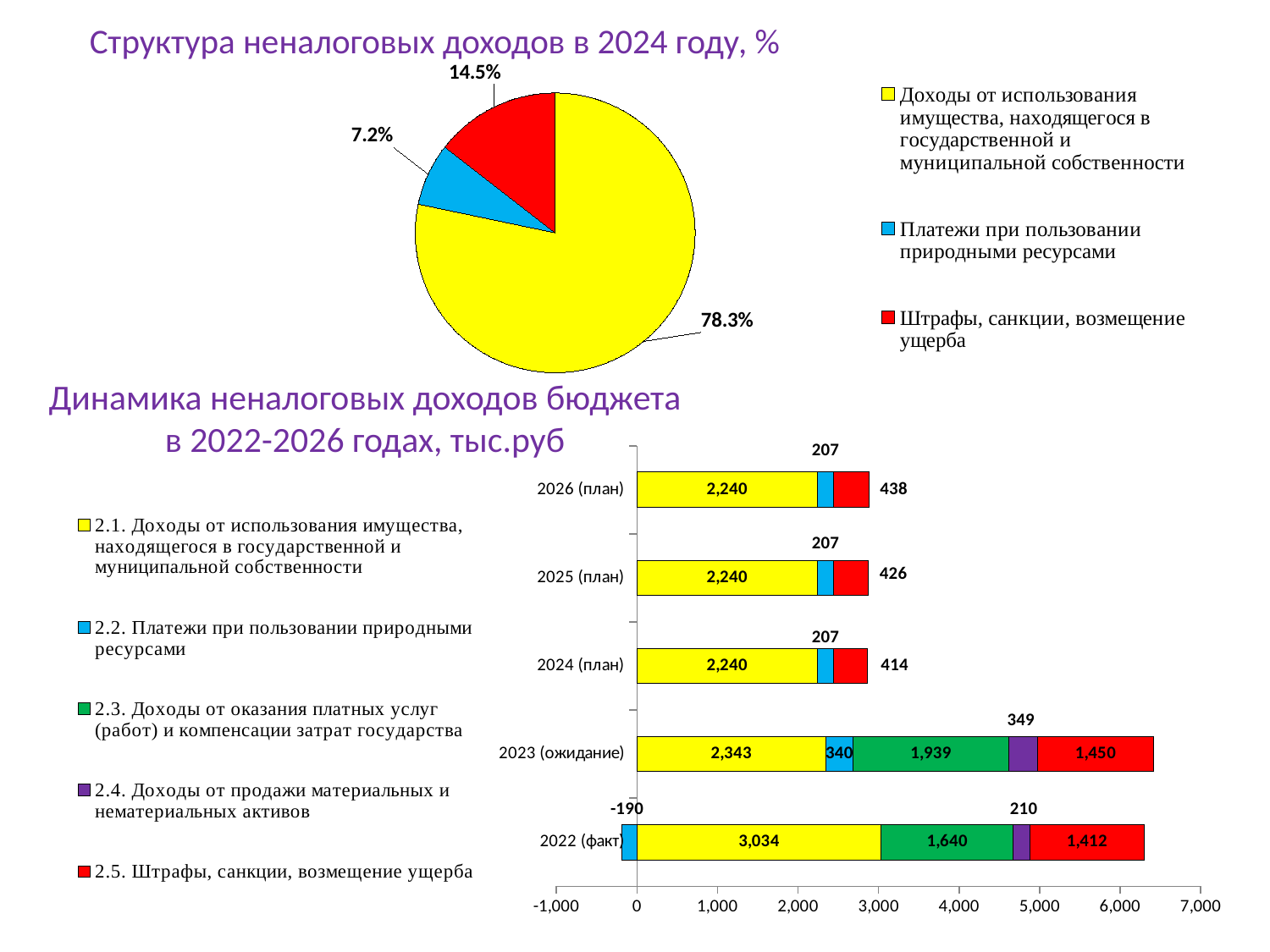
In the chart "Динамика неналоговых доходов бюджета в 2022-2026 годах, тыс.руб", what is the difference between the "2.1. Доходы от использования имущества" values for 2022 (факт) and 2023 (ожидание)? 691 What kind of chart is the chart titled "Структура неналоговых доходов в 2024 году, %"? pie chart In the pie chart "Структура неналоговых доходов в 2024 году, %", which category has the smallest slice? Платежи при пользовании природными ресурсами How many series does the legend of the chart "Динамика неналоговых доходов бюджета в 2022-2026 годах, тыс.руб" list? 5 What kind of chart is the chart titled "Динамика неналоговых доходов бюджета в 2022-2026 годах, тыс.руб"? bar chart In the chart "Динамика неналоговых доходов бюджета в 2022-2026 годах, тыс.руб", what is the total of the stacked bar for 2024 (план)? 2,861 How many categories (years) are shown in the chart "Динамика неналоговых доходов бюджета в 2022-2026 годах, тыс.руб"? 5 How many entries does the legend of the pie chart "Структура неналоговых доходов в 2024 году, %" list? 3 In the pie chart "Структура неналоговых доходов в 2024 году, %", which category has the largest slice? Доходы от использования имущества, находящегося в государственной и муниципальной собственности In the chart "Динамика неналоговых доходов бюджета в 2022-2026 годах, тыс.руб", what is the value of "2.2. Платежи при пользовании природными ресурсами" for 2022 (факт)? -190 In the chart "Динамика неналоговых доходов бюджета в 2022-2026 годах, тыс.руб", what is the value of "2.5. Штрафы, санкции, возмещение ущерба" for 2026 (план)? 438 In the pie chart "Структура неналоговых доходов в 2024 году, %", what share is shown for "Штрафы, санкции, возмещение ущерба"? 14.5%